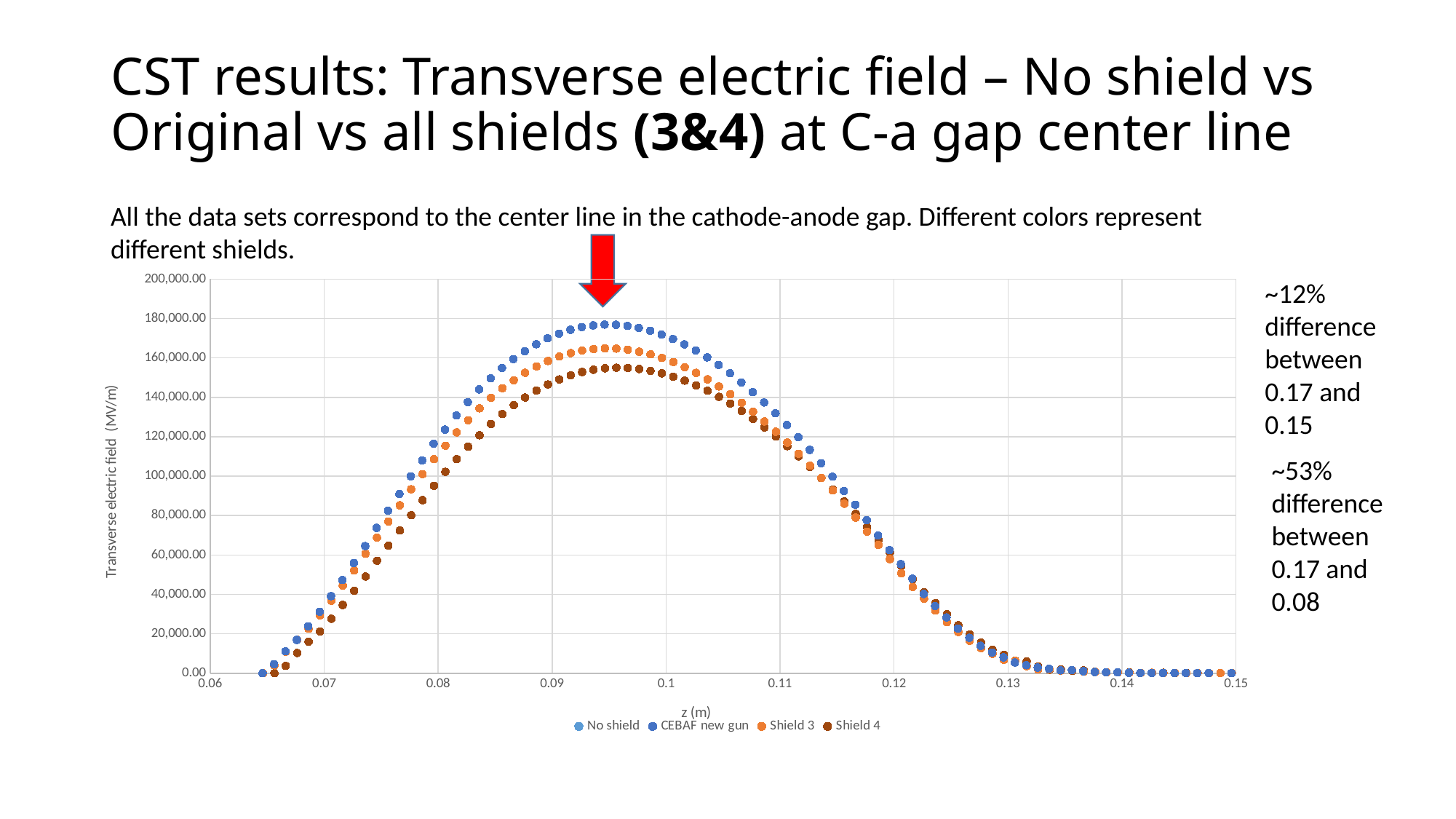
Is the peak value of the CEBAF new gun series greater or less than 180,000.00? less Is the value of the CEBAF new gun series at z = 0.12 greater or less than 80,000.00? less How do the values of the series change as z increases from 0.06 to 0.15? They rise to a peak near z = 0.095 and then fall back to zero Is the peak value of the Shield 3 series greater or less than 160,000.00? greater Which series has the larger peak value, Shield 3 or Shield 4? Shield 3 How many series does the chart legend list? 4 What are the series names listed in the chart legend? No shield, CEBAF new gun, Shield 3, Shield 4 Which series has the lowest peak value on the chart? Shield 4 What is the label of the chart's x axis? z (m) What kind of chart is shown on the slide? scatter chart